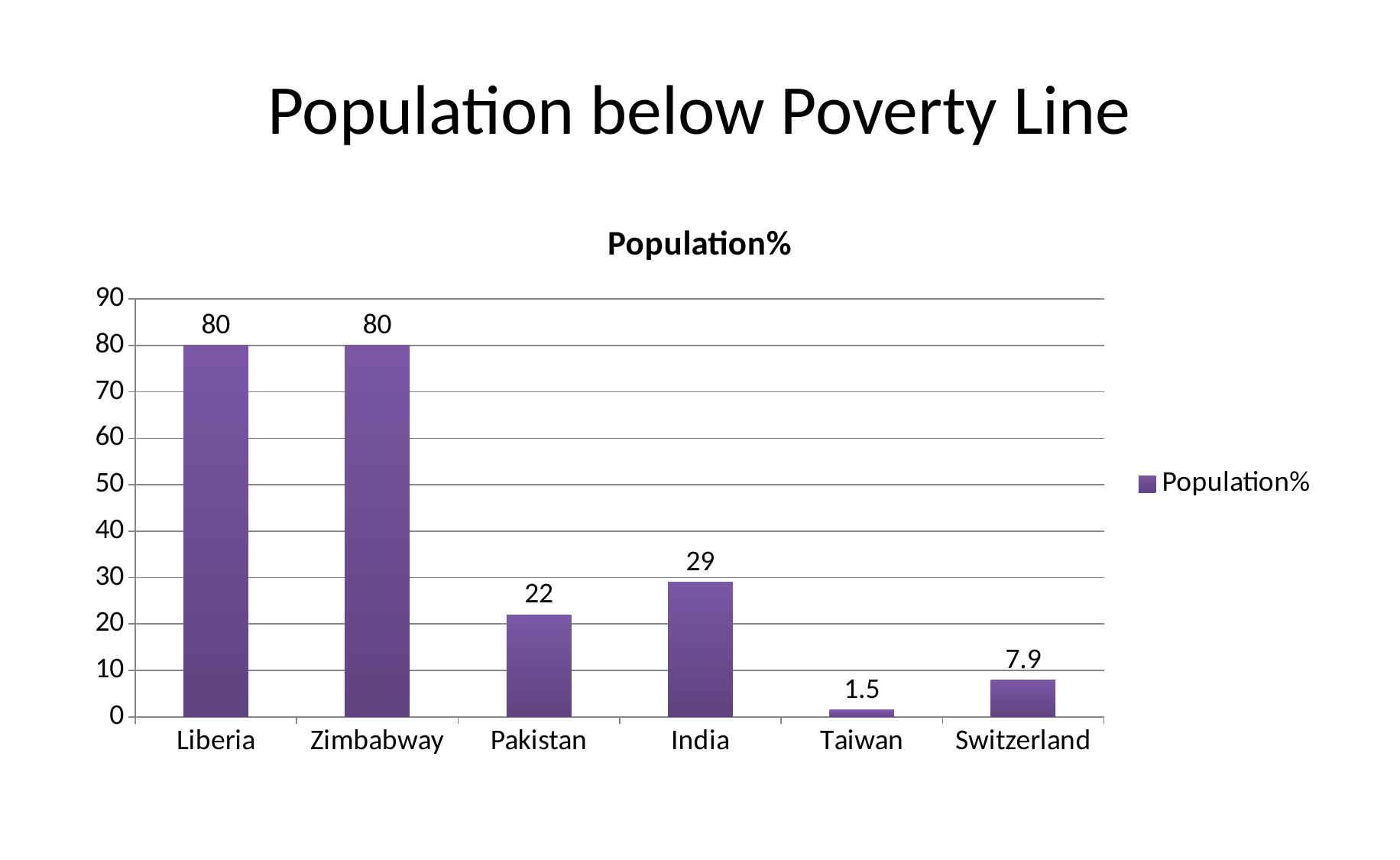
What is the Population% value for Pakistan? 22 What is the difference between the Population% values for India and Pakistan? 7 What is the Population% value for Switzerland? 7.9 What kind of chart is shown on the slide? bar chart How many series does the legend list? 1 How many countries are shown on the chart? 6 Which has a larger Population% value, India or Switzerland? India What is the Population% value for Taiwan? 1.5 What is the difference between the Population% values for Liberia and Switzerland? 72.1 What is the Population% value for India? 29 Which country has the lowest Population% value? Taiwan Is the value for Pakistan greater or less than 30? less